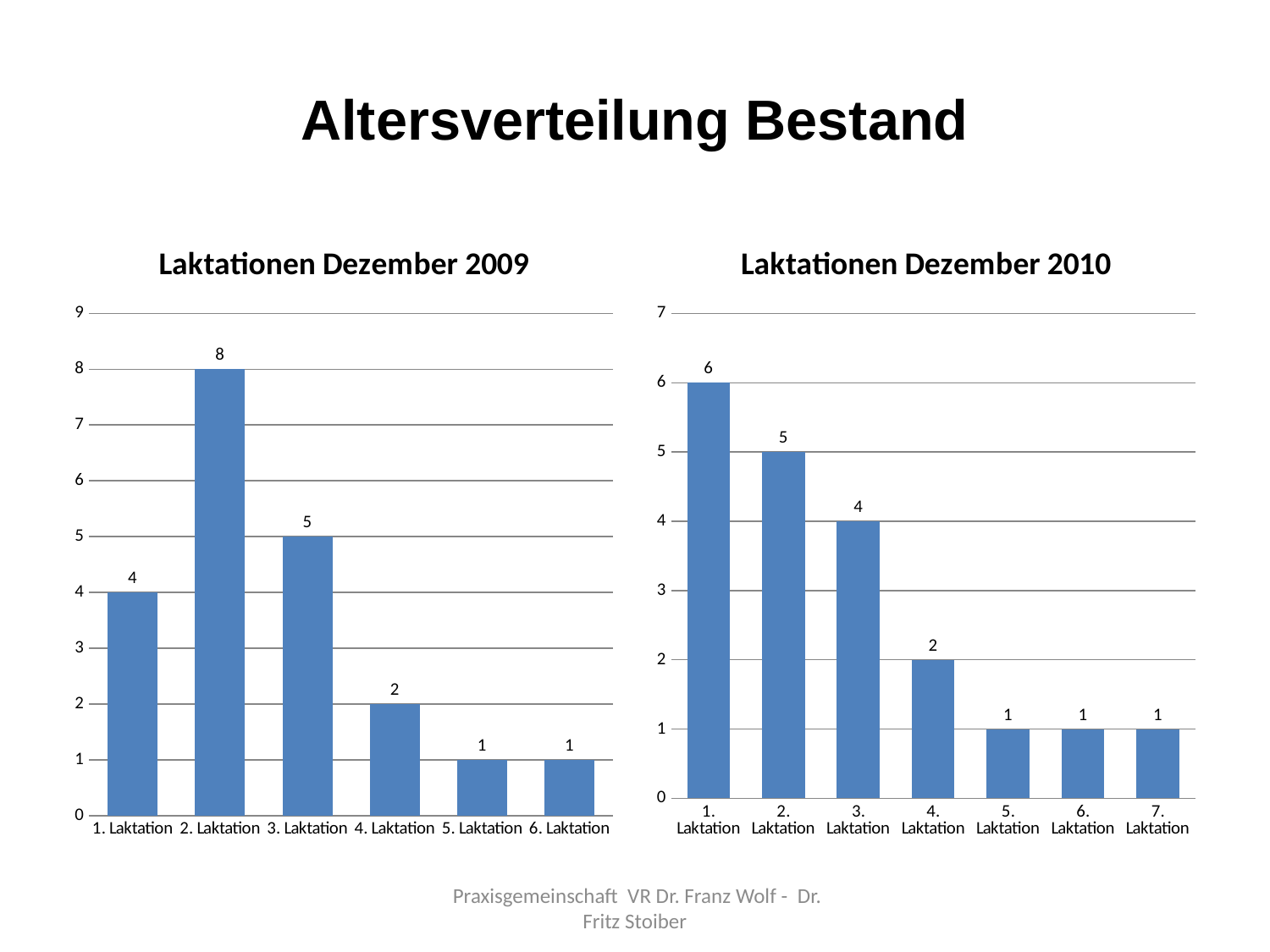
In the 'Laktationen Dezember 2009' chart, which category has the highest value? 2. Laktation In the 'Laktationen Dezember 2010' chart, which category has the highest value? 1. Laktation How many categories are shown in the 'Laktationen Dezember 2010' chart? 7 In the 'Laktationen Dezember 2010' chart, do the values rise or fall from 1. Laktation to 5. Laktation? Fall In the 'Laktationen Dezember 2010' chart, what is the difference between the values for 1. Laktation and 4. Laktation? 4 In the 'Laktationen Dezember 2009' chart, which is larger, the value for 1. Laktation or the value for 3. Laktation? 3. Laktation How many categories are shown in the 'Laktationen Dezember 2009' chart? 6 In the 'Laktationen Dezember 2010' chart, what is the value for 3. Laktation? 4 In the 'Laktationen Dezember 2009' chart, what is the difference between the values for 2. Laktation and 3. Laktation? 3 What is the title of the chart on the left side of the slide? Laktationen Dezember 2009 What kind of chart is the 'Laktationen Dezember 2010' chart? Bar chart In the 'Laktationen Dezember 2009' chart, what is the value for 2. Laktation? 8